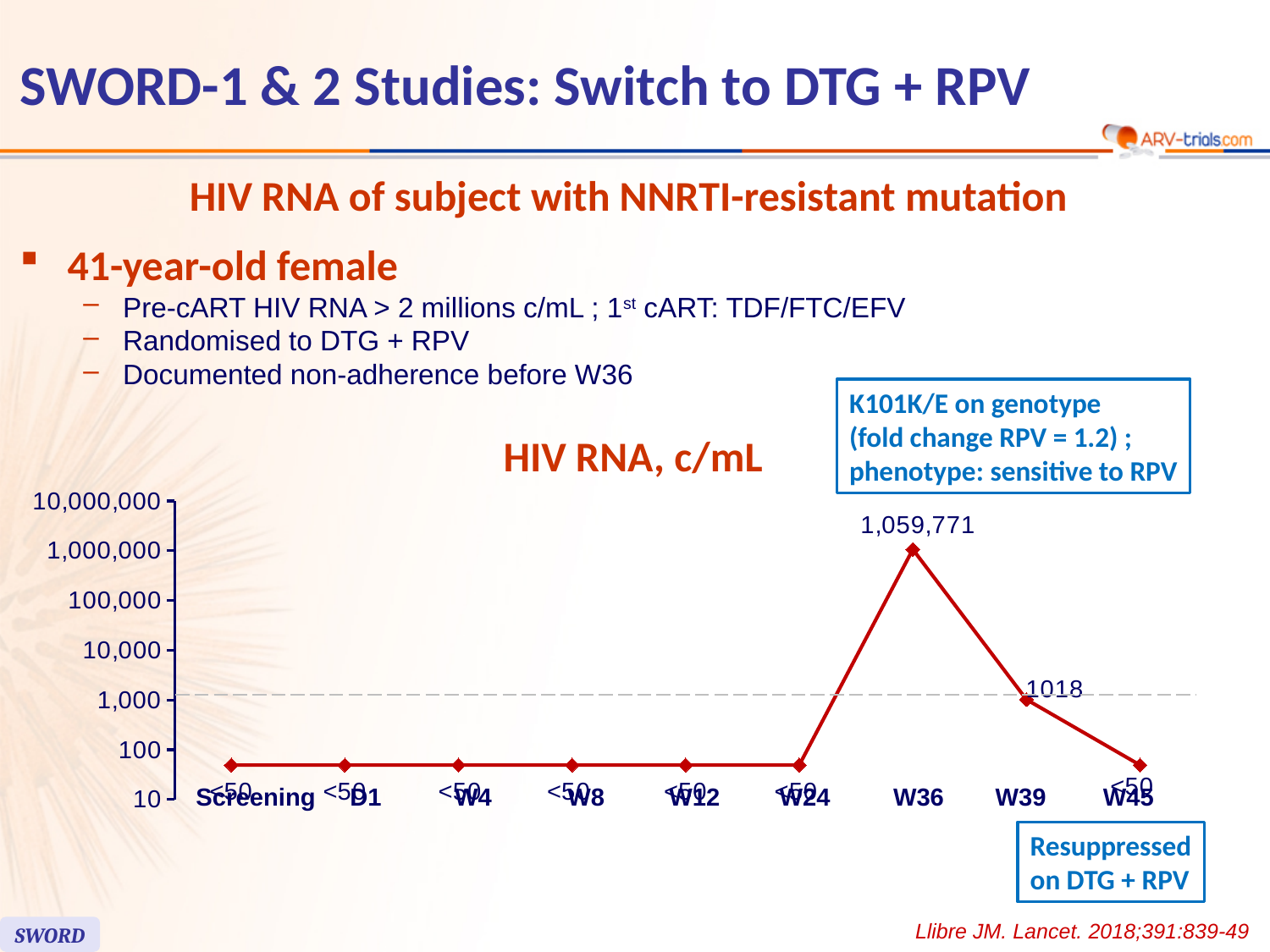
Is the HIV RNA value at W24 greater or less than 100? less What is the HIV RNA value at W39? 1018 Do the HIV RNA values rise or fall from W36 to W45? fall What is the HIV RNA value at W36? 1,059,771 At which time point is HIV RNA highest? W36 Which time point has the larger HIV RNA value, W36 or W39? W36 What is the title of the chart? HIV RNA, c/mL How many time points are plotted on the x axis? 9 What is the difference between the HIV RNA values at W36 and W39? 1,058,753 What kind of chart is used to show HIV RNA? line chart Is the HIV RNA value at W36 greater or less than 1,000,000? greater What is the HIV RNA value shown at W45? <50